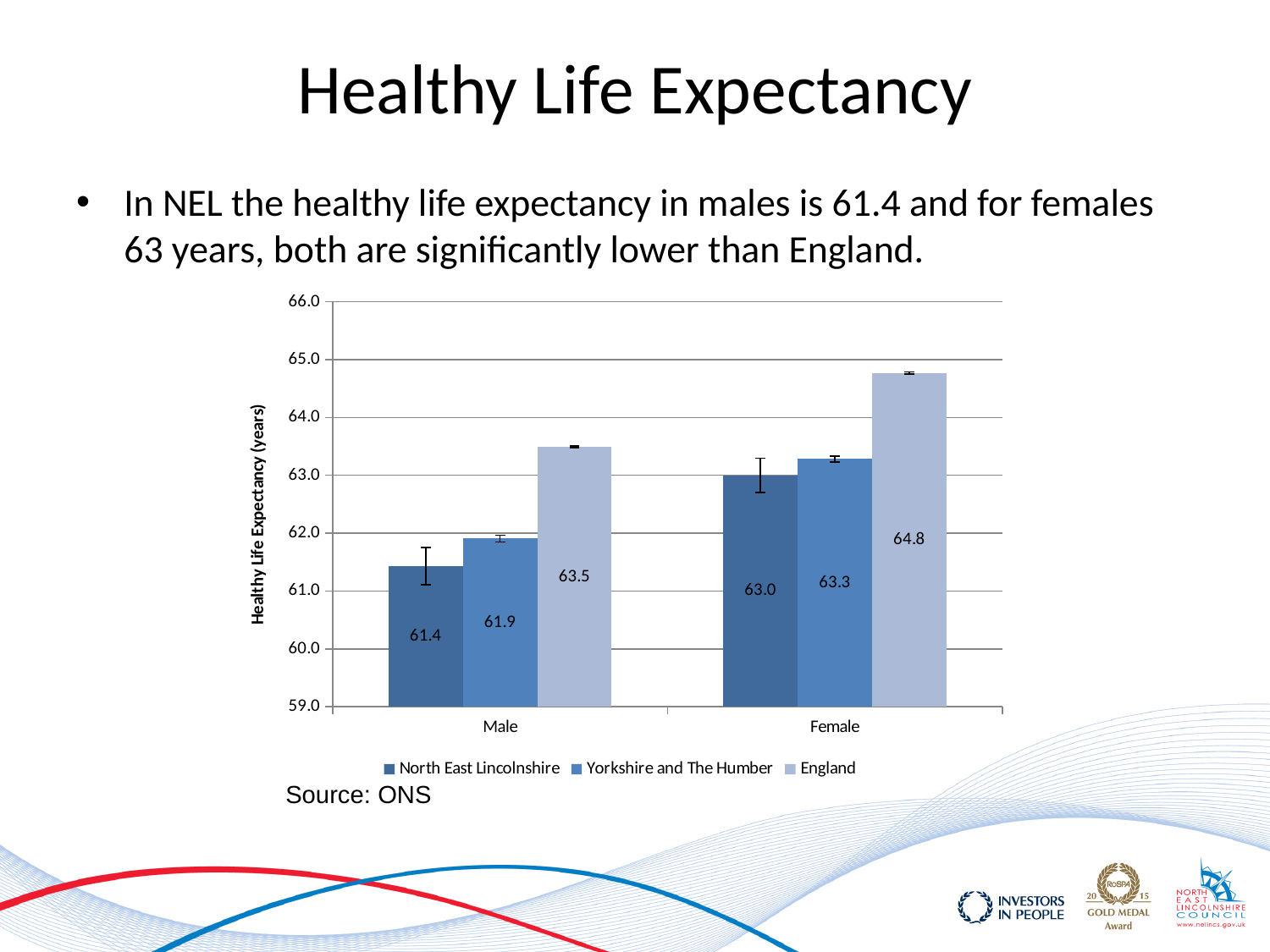
Which is larger: the healthy life expectancy for males in Yorkshire and The Humber or for females in North East Lincolnshire? Females in North East Lincolnshire Which series has the lowest healthy life expectancy for females? North East Lincolnshire What is the healthy life expectancy for males in North East Lincolnshire? 61.4 How many categories are shown on the x axis? 2 What kind of chart is shown on the slide? Bar chart What is the difference between the England and North East Lincolnshire healthy life expectancy for females? 1.8 What is the healthy life expectancy for females in Yorkshire and The Humber? 63.3 What is the healthy life expectancy for females in England? 64.8 What is the difference between the England and North East Lincolnshire healthy life expectancy for males? 2.1 How many series does the legend list? 3 What is the label of the y axis? Healthy Life Expectancy (years) Which series has the highest healthy life expectancy for males? England